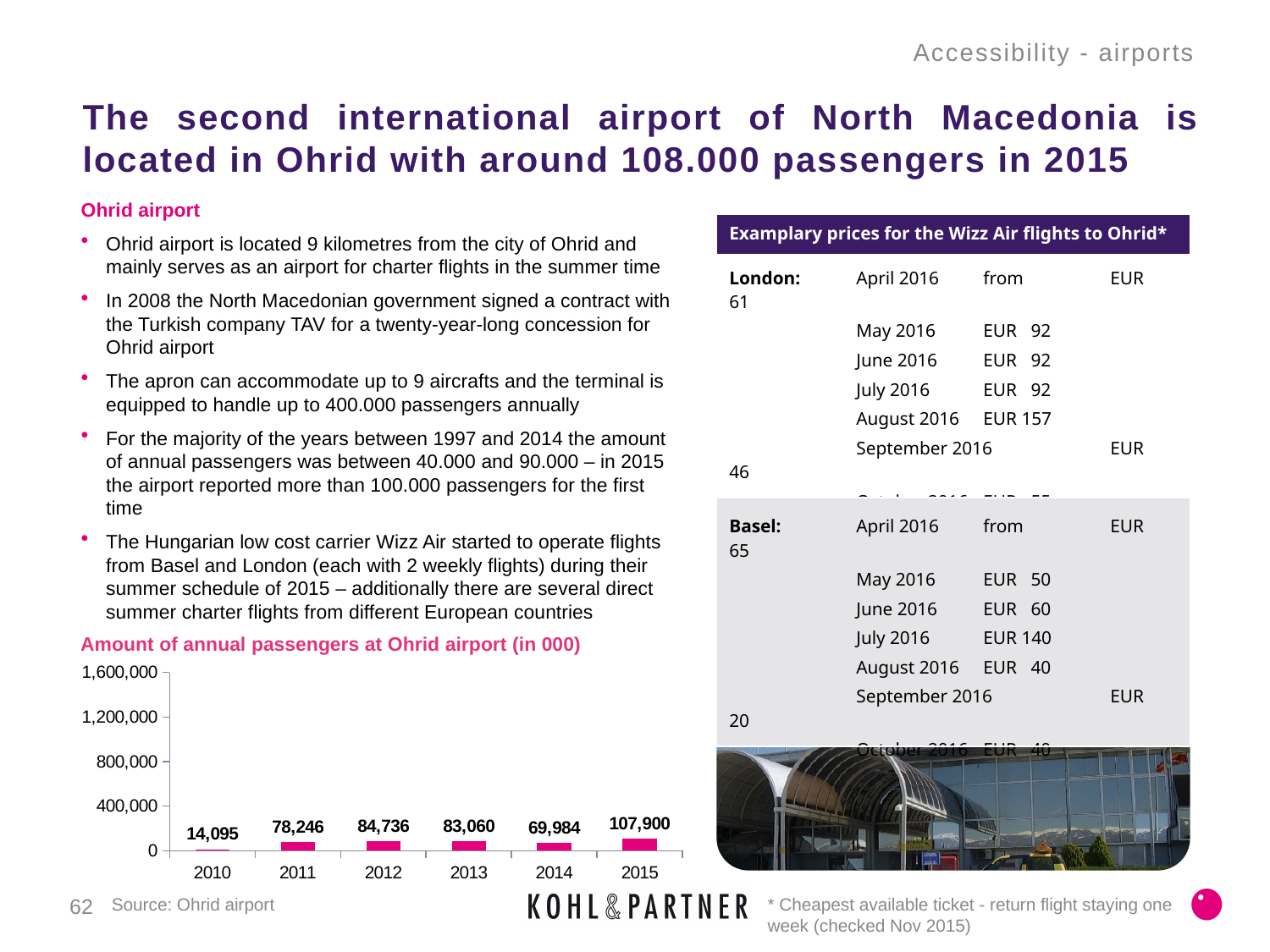
What is the value for 2015 in the chart? 107,900 Is the value for 2015 in the chart greater or less than 400,000? less Which year has the highest value in the chart? 2015 What is the difference between the values for 2011 and 2010 in the chart? 64,151 What is the title of the chart on the slide? Amount of annual passengers at Ohrid airport (in 000) How many years are shown on the x axis of the chart? 6 Which is larger in the chart, the value for 2012 or the value for 2013? 2012 What is the difference between the values for 2015 and 2014 in the chart? 37,916 Which year has the lowest value in the chart? 2010 What is the value for 2013 in the chart? 83,060 What is the value for 2010 in the chart? 14,095 What type of chart is shown on the slide? bar chart